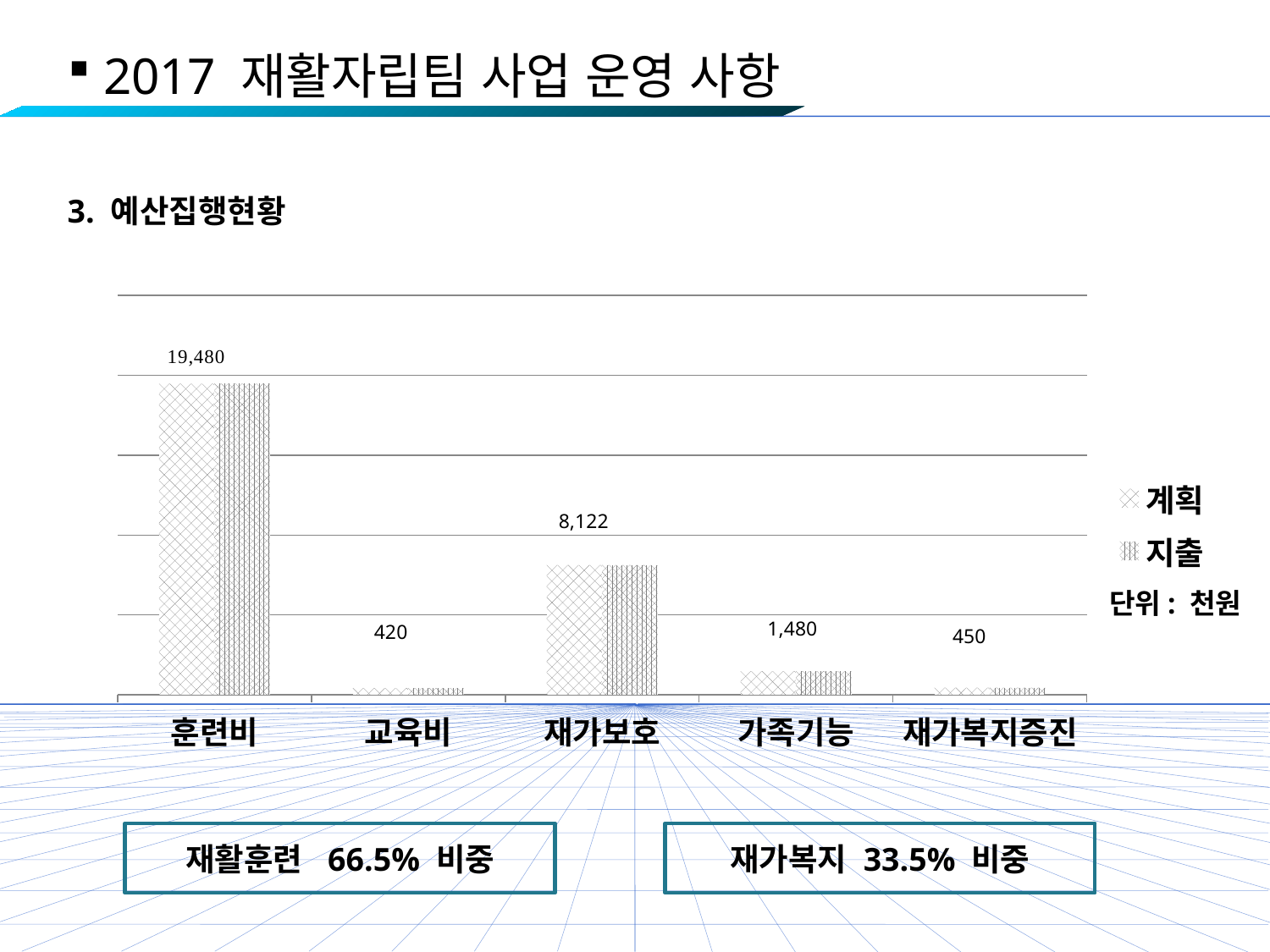
What value is labelled for 재가보호? 8,122 Which is larger, the value for 재가보호 or the value for 가족기능? 재가보호 How many series does the legend list? 2 Which category has the highest value? 훈련비 What value is labelled for 훈련비? 19,480 What value is labelled for 가족기능? 1,480 What value is labelled for 교육비? 420 Which category has the lowest labelled value? 교육비 What is the difference between the labelled values for 가족기능 and 재가복지증진? 1,030 How many categories are shown on the x axis? 5 What kind of chart is shown on the slide? Bar chart What is the difference between the labelled values for 훈련비 and 재가보호? 11,358